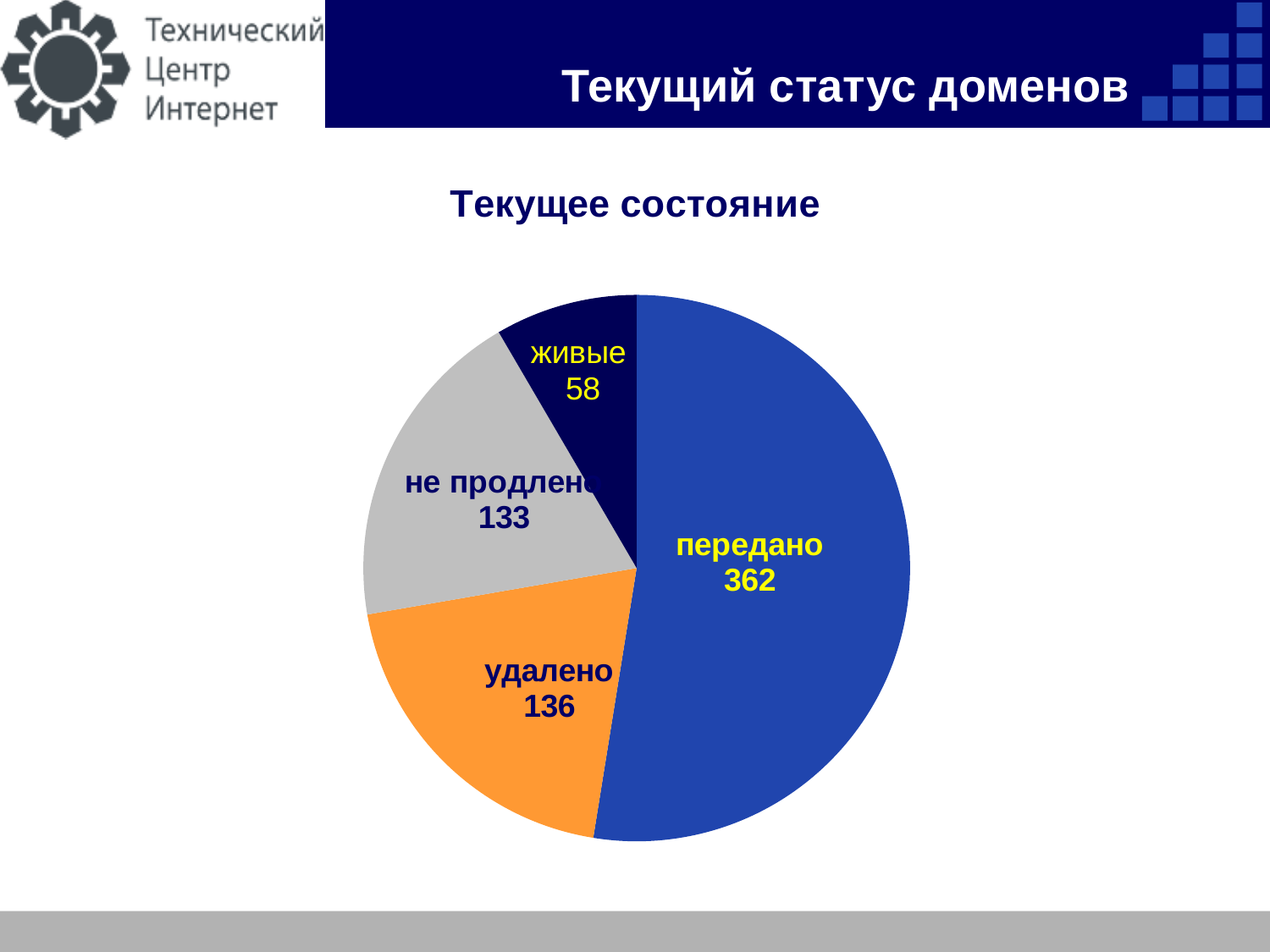
What is the value for the slice "не продлено"? 133 What is the total of all four slices in the pie chart? 689 What is the value for the slice "передано"? 362 Which category has the smallest slice? живые What is the value for the slice "удалено"? 136 What is the difference between the values for "передано" and "удалено"? 226 Which is larger, the value for "удалено" or the value for "не продлено"? удалено Which category has the largest slice? передано How many slices does the pie chart have? 4 What type of chart is shown on the slide? pie chart What is the title of the chart? Текущее состояние What is the value for the slice "живые"? 58